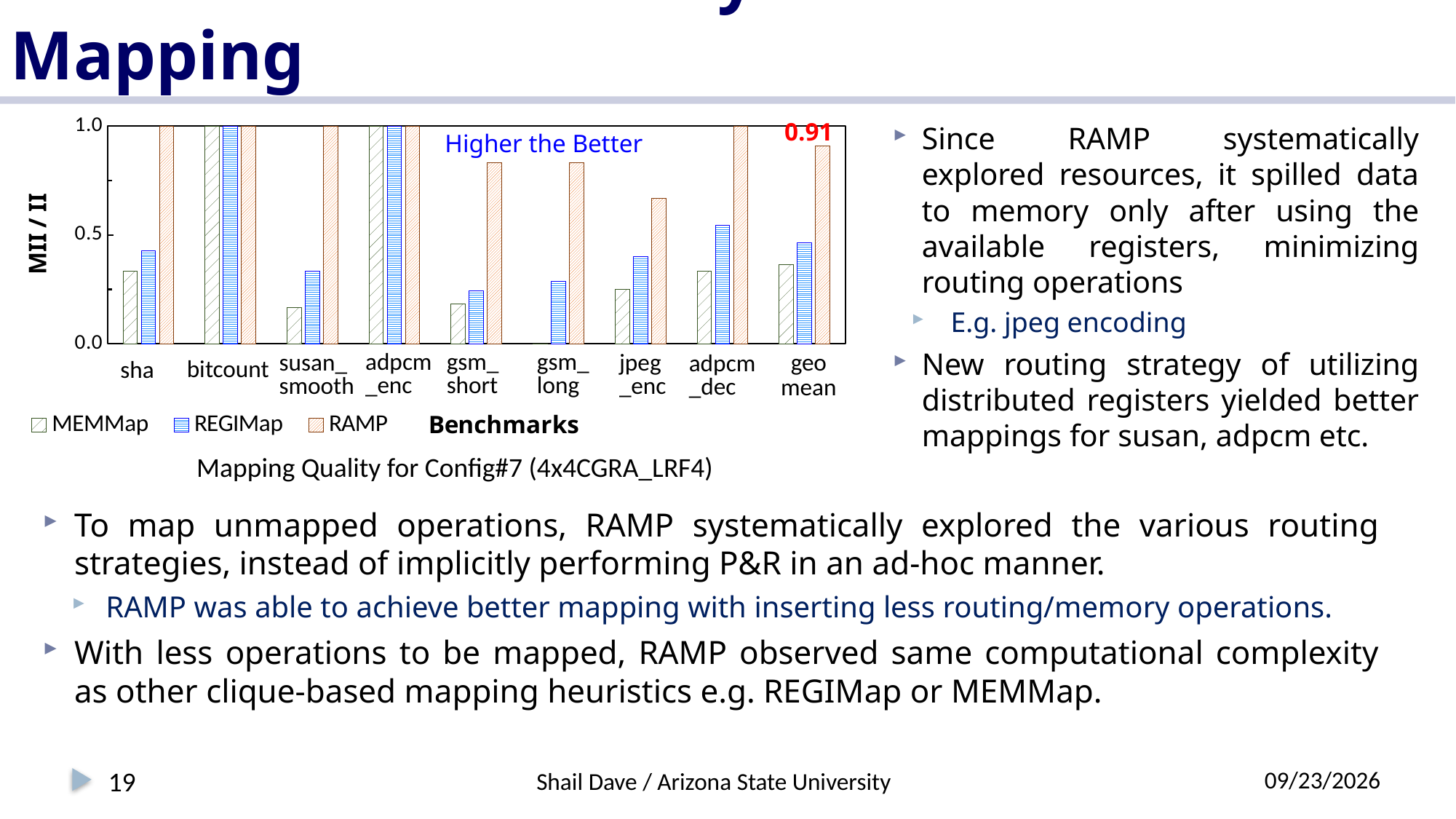
How many benchmarks are shown on the x axis? 9 What is the RAMP value for the geo mean benchmark? 0.91 Is the REGIMap value for gsm_short greater or less than 0.5? less Is the RAMP value for jpeg_enc greater or less than 0.5? greater Is the MEMMap value for sha greater or less than 0.5? less For the gsm_long benchmark, which is larger: the REGIMap value or the MEMMap value? REGIMap How many series does the legend list? 3 What kind of chart is shown on the slide? bar chart Which series has the highest value for the geo mean benchmark? RAMP What is the label of the y axis? MII / II For the sha benchmark, which is larger: the RAMP value or the MEMMap value? RAMP What is the RAMP value for the bitcount benchmark? 1.0